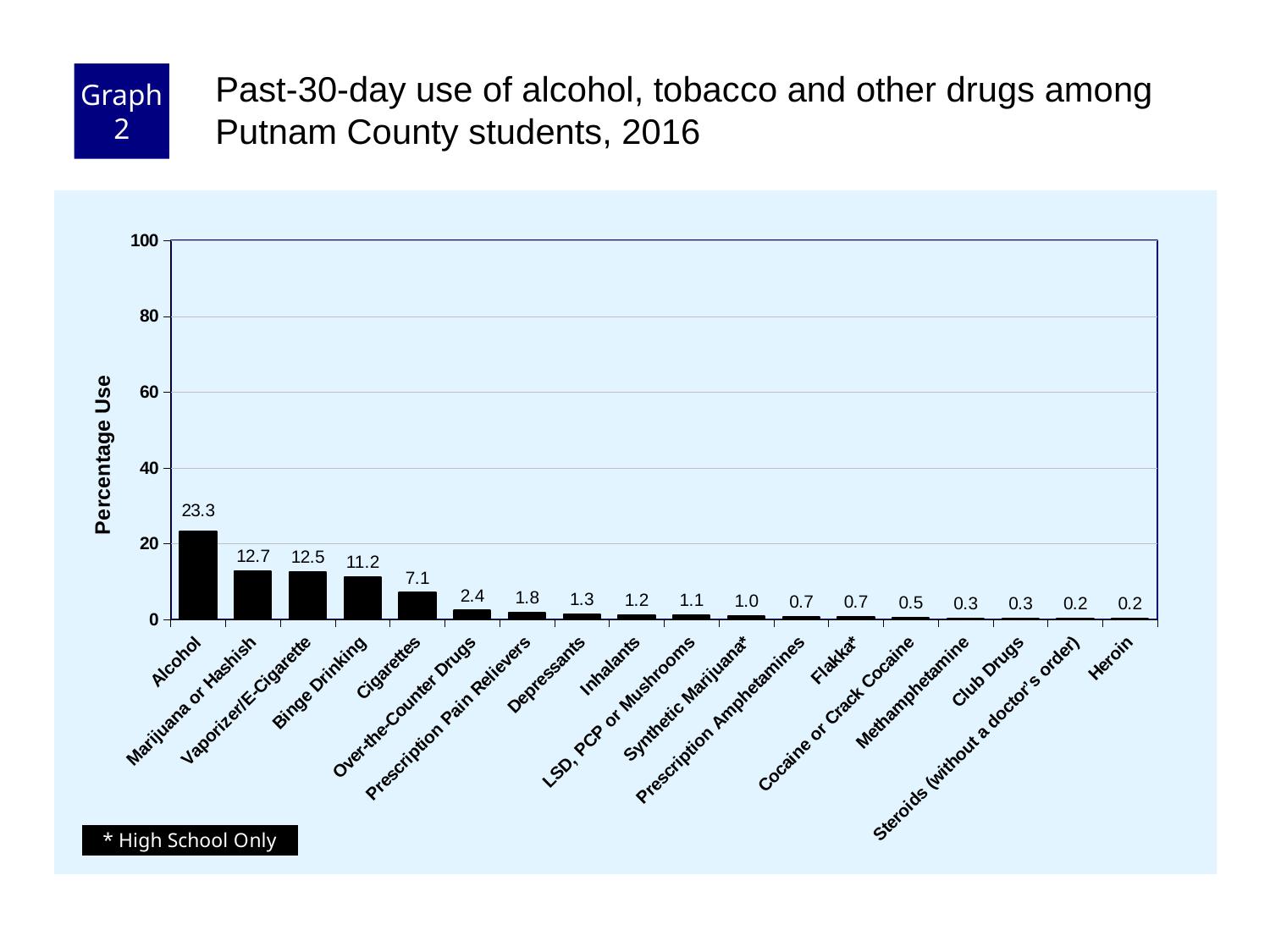
Which category has the highest percentage use? Alcohol What is the percentage use for Cigarettes? 7.1 What is the difference in percentage use between Alcohol and Marijuana or Hashish? 10.6 What kind of chart is shown on the slide? Bar chart What is the label of the y axis? Percentage Use Is the value for Alcohol greater or less than 20? greater How many categories are shown on the x axis? 18 What is the difference in percentage use between Binge Drinking and Cigarettes? 4.1 What is the percentage use for Over-the-Counter Drugs? 2.4 What is the percentage use for Binge Drinking? 11.2 Which has a higher percentage use, Marijuana or Hashish or Vaporizer/E-Cigarette? Marijuana or Hashish What is the percentage use for Alcohol? 23.3